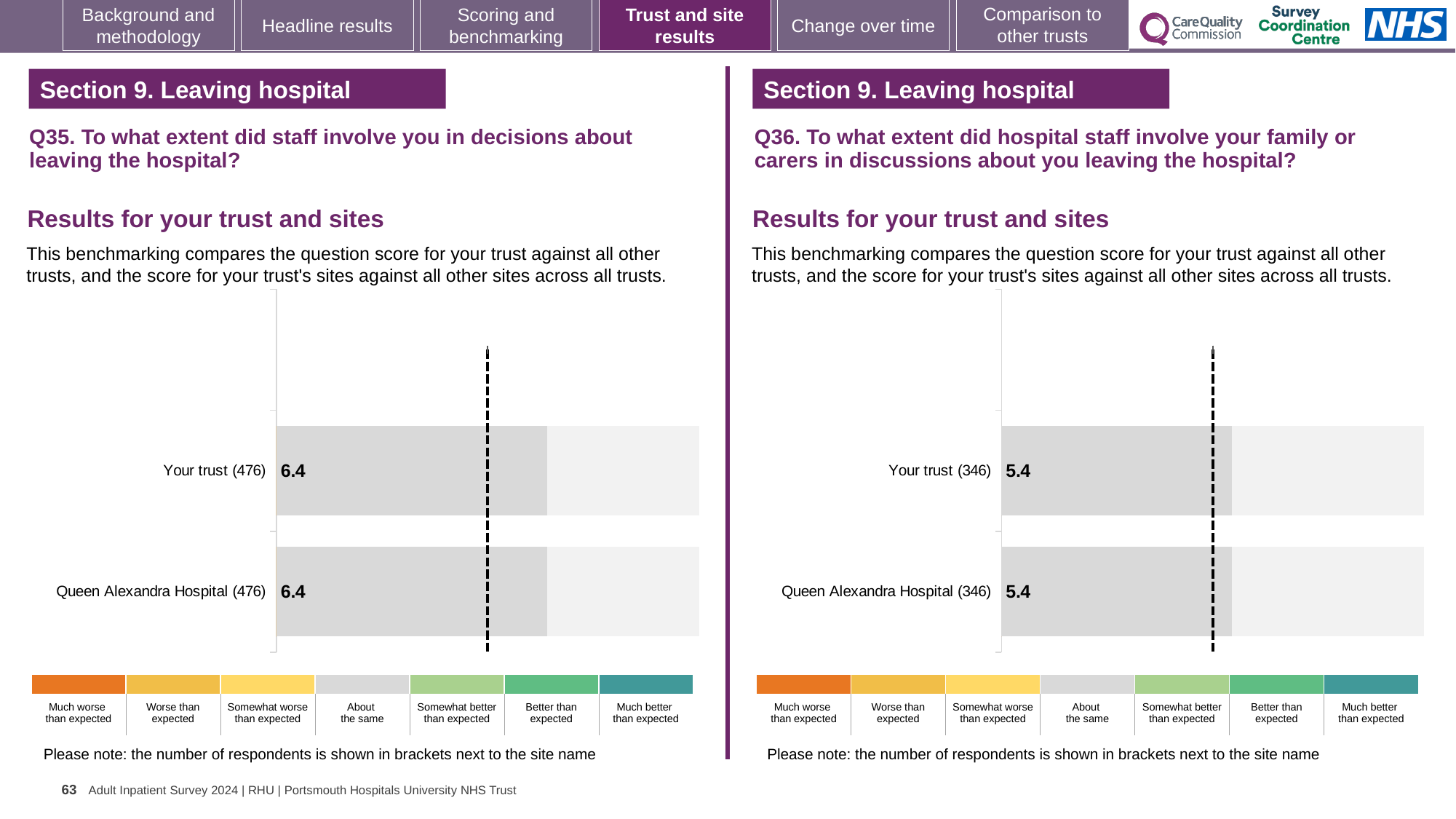
How many bars are plotted in the Q35 chart on the left? 2 How many bars are plotted in the Q36 chart on the right? 2 In the Q35 chart on the left, what is the score for Queen Alexandra Hospital? 6.4 In the Q35 chart on the left, what is the score for Your trust? 6.4 In the Q35 chart on the left, how many respondents are shown in brackets next to Your trust? 476 In the Q36 chart on the right, what is the score for Queen Alexandra Hospital? 5.4 What kind of chart is the Q35 chart on the left? Bar chart Is the score for Your trust in the Q35 chart on the left larger than the score for Your trust in the Q36 chart on the right? Yes In the Q35 chart on the left, what is the difference between the score for Your trust and the score for Queen Alexandra Hospital? 0 In the Q36 chart on the right, what is the score for Your trust? 5.4 In the Q36 chart on the right, what is the difference between the score for Your trust and the score for Queen Alexandra Hospital? 0 In the Q36 chart on the right, how many respondents are shown in brackets next to Queen Alexandra Hospital? 346